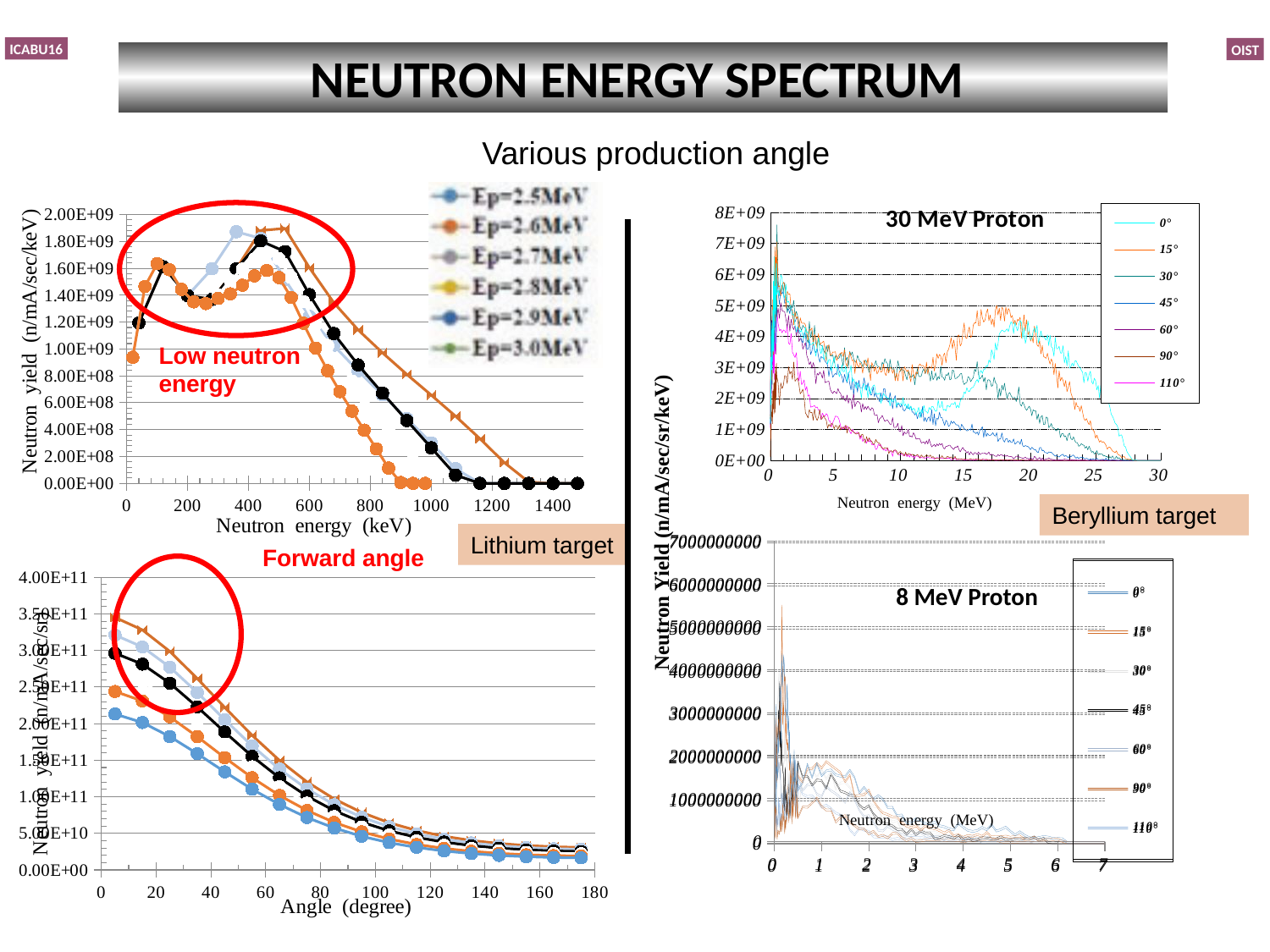
In the bottom-left chart (neutron yield versus angle), is the lowest series value at 5 degrees greater or less than 2.50E+11? less How many series does the legend of the top-left chart (Ep=2.5MeV to Ep=3.0MeV) list? 6 What is the maximum value shown on the x axis of the '30 MeV Proton' chart? 30 In the top-left chart (neutron yield versus neutron energy in keV), is the peak value of the highest series greater or less than 1.60E+09? greater What is the x-axis label of the bottom-left chart? Angle (degree) What kind of chart is the top-left chart (neutron yield versus neutron energy in keV)? line chart How many angle series does the legend of the '30 MeV Proton' chart list? 7 In the bottom-left chart (neutron yield versus angle), are the values at 175 degrees greater or less than 5.00E+10? less In the bottom-left chart (neutron yield versus angle), do the values rise or fall as the angle increases? fall What is the title shown inside the top-right chart? 30 MeV Proton